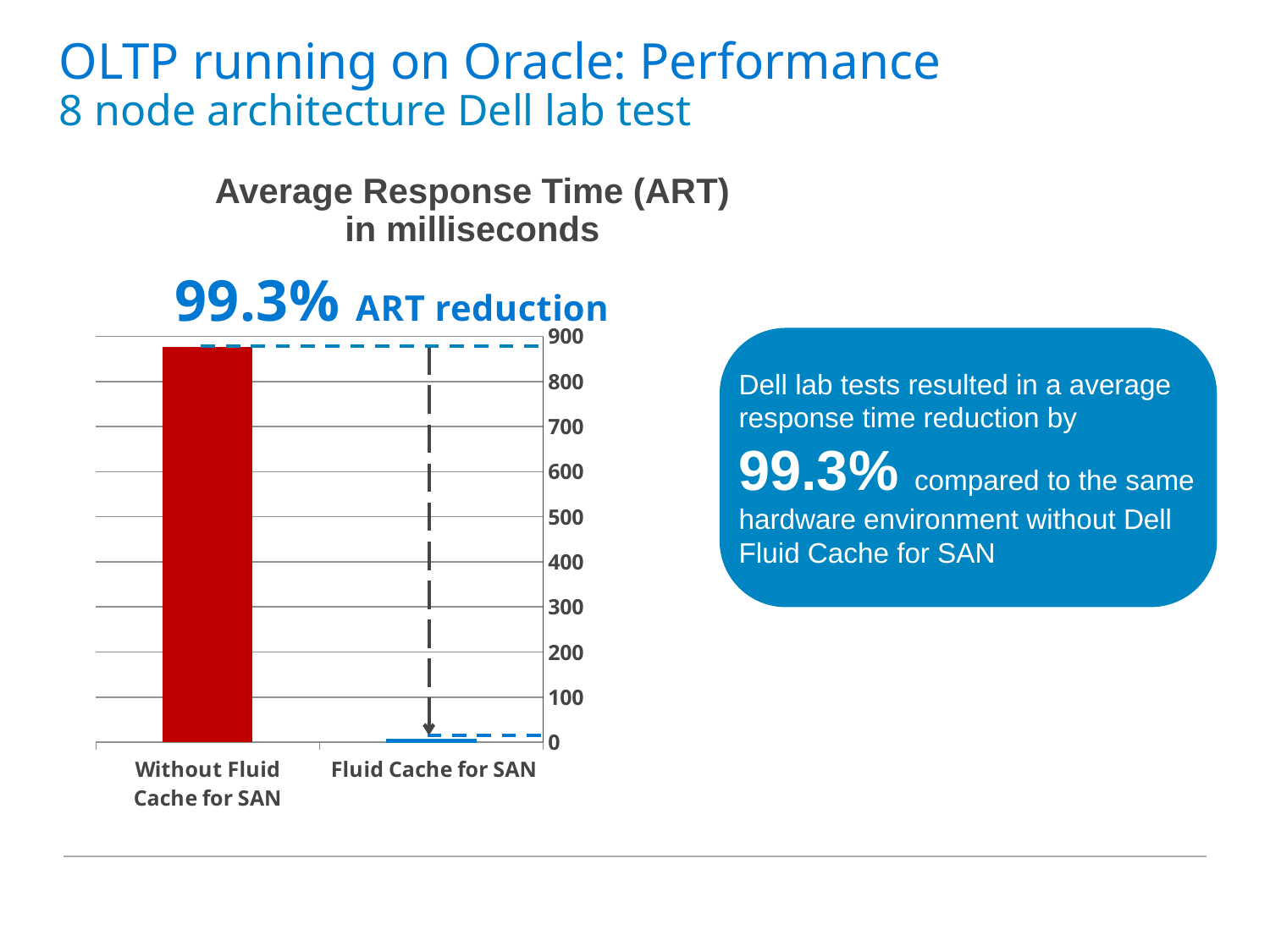
Which category has the highest average response time? Without Fluid Cache for SAN What ART reduction percentage is annotated above the chart? 99.3% Which is larger, the value for Without Fluid Cache for SAN or the value for Fluid Cache for SAN? Without Fluid Cache for SAN How many categories are plotted on the x axis of the chart? 2 What kind of chart is shown on the slide? bar chart Which category has the lowest average response time? Fluid Cache for SAN Do the values rise or fall from left to right along the x axis? fall Is the value for Without Fluid Cache for SAN greater or less than 900? less Is the value for Without Fluid Cache for SAN greater or less than 800? greater What is the title of the chart? Average Response Time (ART) in milliseconds Is the value for Fluid Cache for SAN greater or less than 100? less